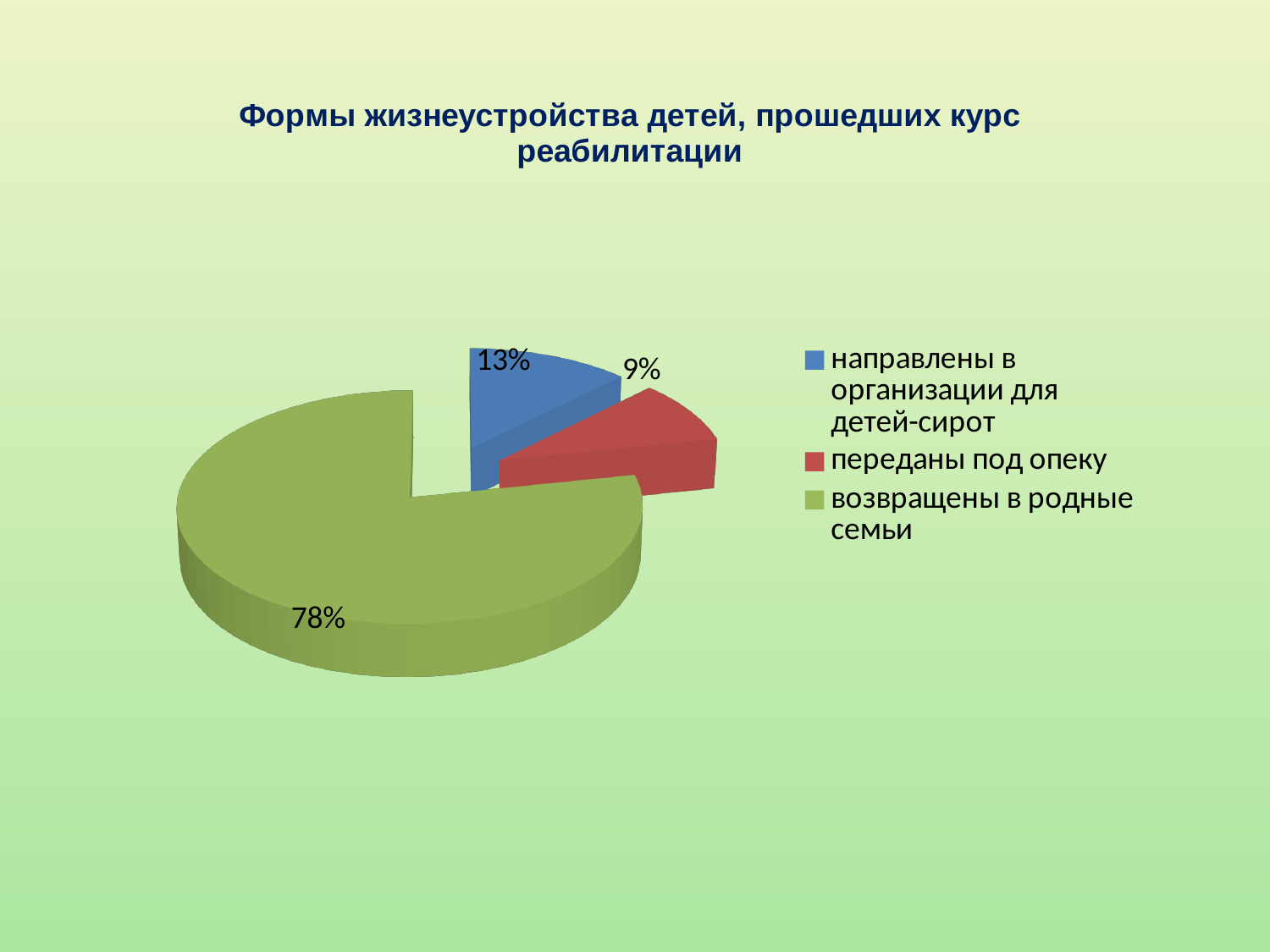
What share of the pie is labelled "переданы под опеку"? 9% What colour is the slice for "переданы под опеку"? red What is the difference in percentage points between "направлены в организации для детей-сирот" and "переданы под опеку"? 4 What kind of chart is shown on the slide? pie chart What is the title of the chart? Формы жизнеустройства детей, прошедших курс реабилитации What share of the pie is labelled "возвращены в родные семьи"? 78% Which is larger: the slice for "направлены в организации для детей-сирот" or the slice for "переданы под опеку"? направлены в организации для детей-сирот Which category has the largest slice of the pie? возвращены в родные семьи Which category has the smallest slice of the pie? переданы под опеку What share of the pie is labelled "направлены в организации для детей-сирот"? 13% How many slices does the pie chart have? 3 What is the difference in percentage points between "возвращены в родные семьи" and "направлены в организации для детей-сирот"? 65